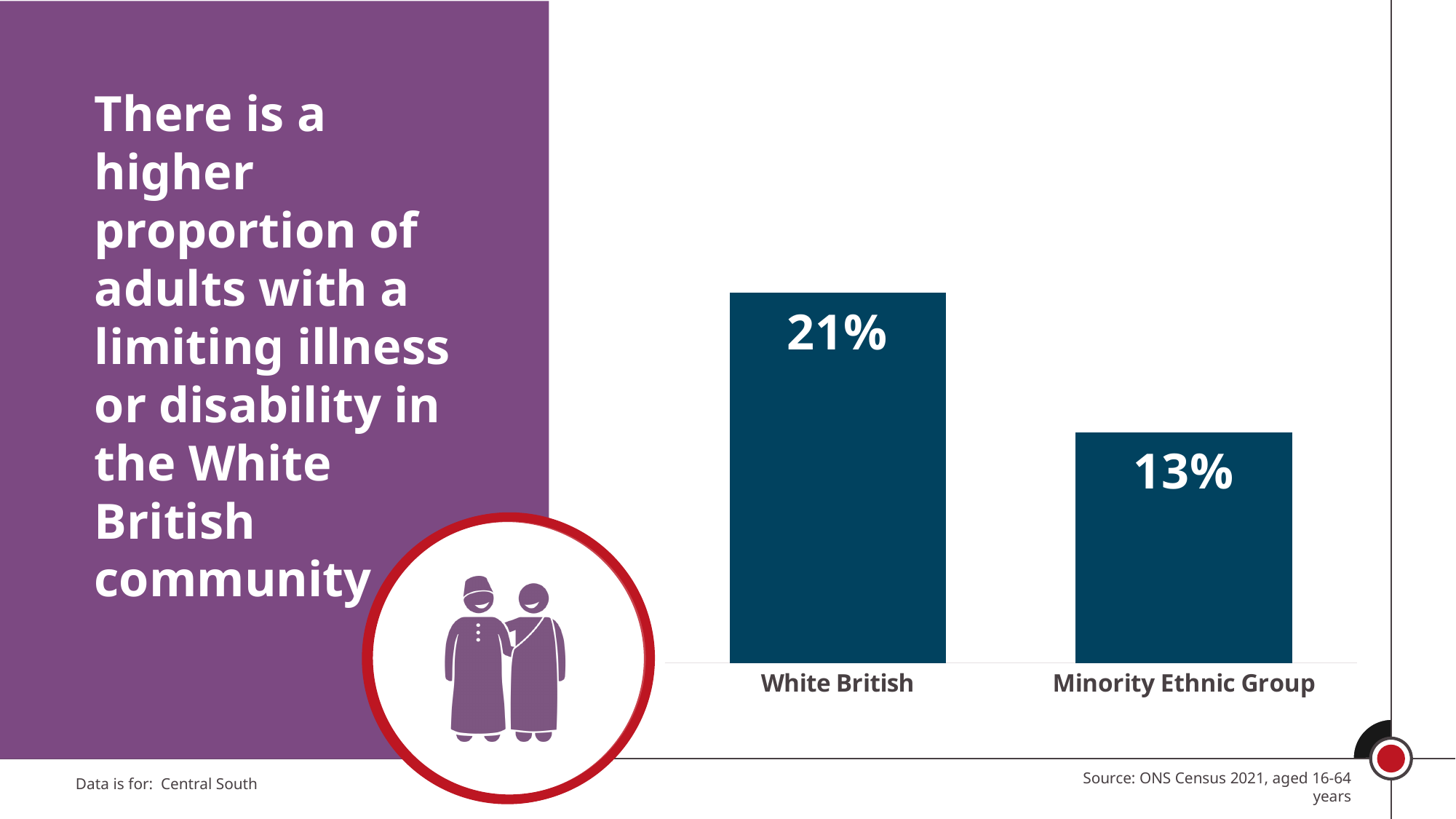
What is the value for White British? 21% Do the values rise or fall from left to right across the categories? Fall How many categories are shown in the chart? 2 Which is larger, the value for White British or the value for Minority Ethnic Group? White British According to the source note, which census is the chart data from? ONS Census 2021 What is the value for Minority Ethnic Group? 13% Which category has the highest value? White British What colour are the bars in the chart? Dark blue What is the difference between the values for White British and Minority Ethnic Group? 8% Which category has the lowest value? Minority Ethnic Group What kind of chart is shown on the slide? Bar chart